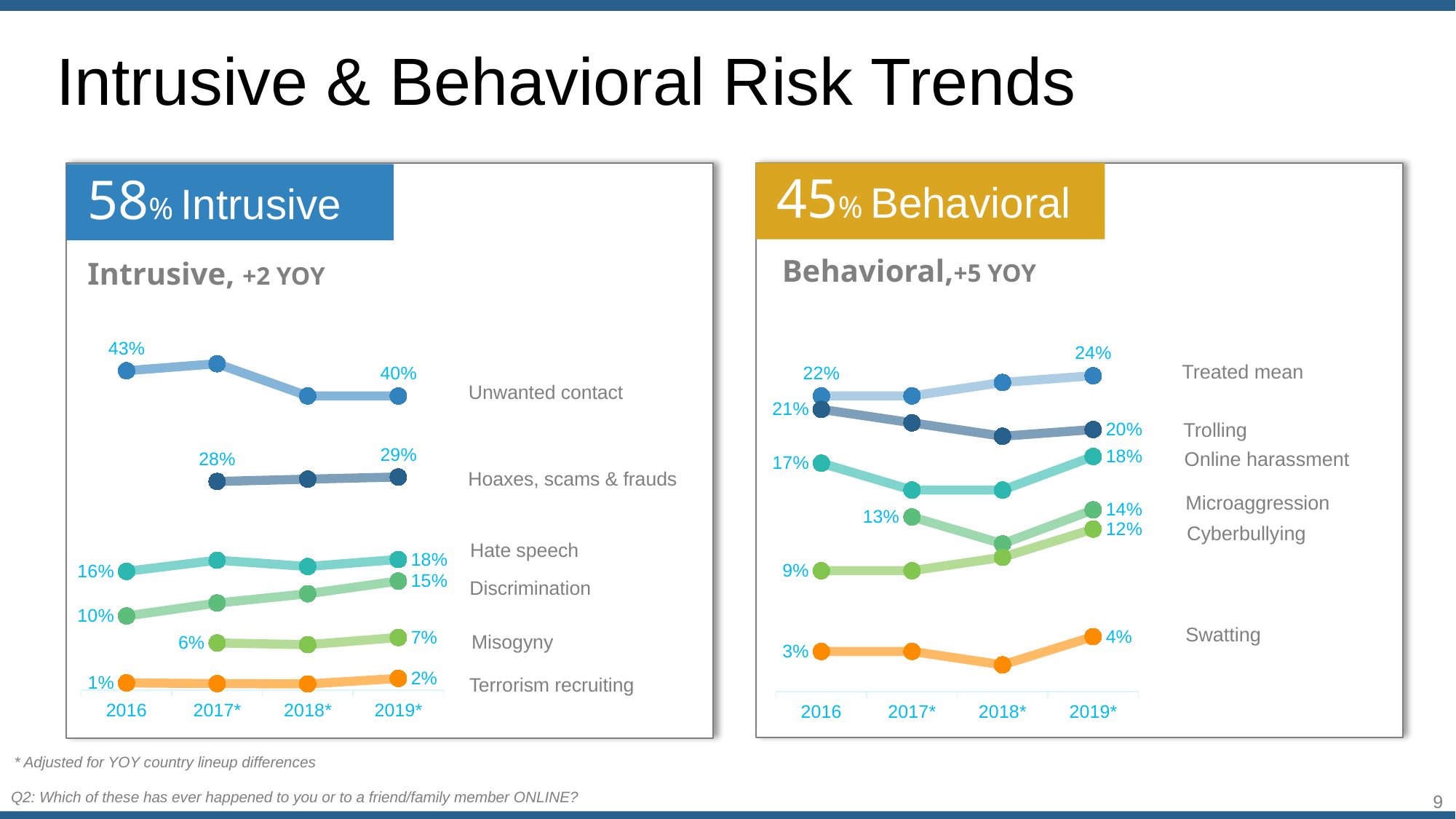
In the Behavioral chart, what is the value for Cyberbullying in 2016? 9% In the Intrusive chart, does the Discrimination line rise or fall from 2016 to 2019*? Rise In the Behavioral chart, which series has the lowest value in 2016? Swatting In the Intrusive chart, what is the value for Unwanted contact in 2019*? 40% In the Intrusive chart, what is the difference between the Unwanted contact values in 2016 and 2019*? 3% In the Behavioral chart, what is the difference between the Trolling and Online harassment values in 2019*? 2% In the Intrusive chart, which series has the highest value in 2019*? Unwanted contact In the Behavioral chart, what is the value for Treated mean in 2019*? 24% In the Intrusive chart, what is the value for Hoaxes, scams & frauds in 2017*? 28% In the Behavioral chart, which is larger in 2019*: Microaggression or Cyberbullying? Microaggression How many years are shown on the x axis of the Intrusive chart? 4 What kind of chart is the Behavioral chart? Line chart